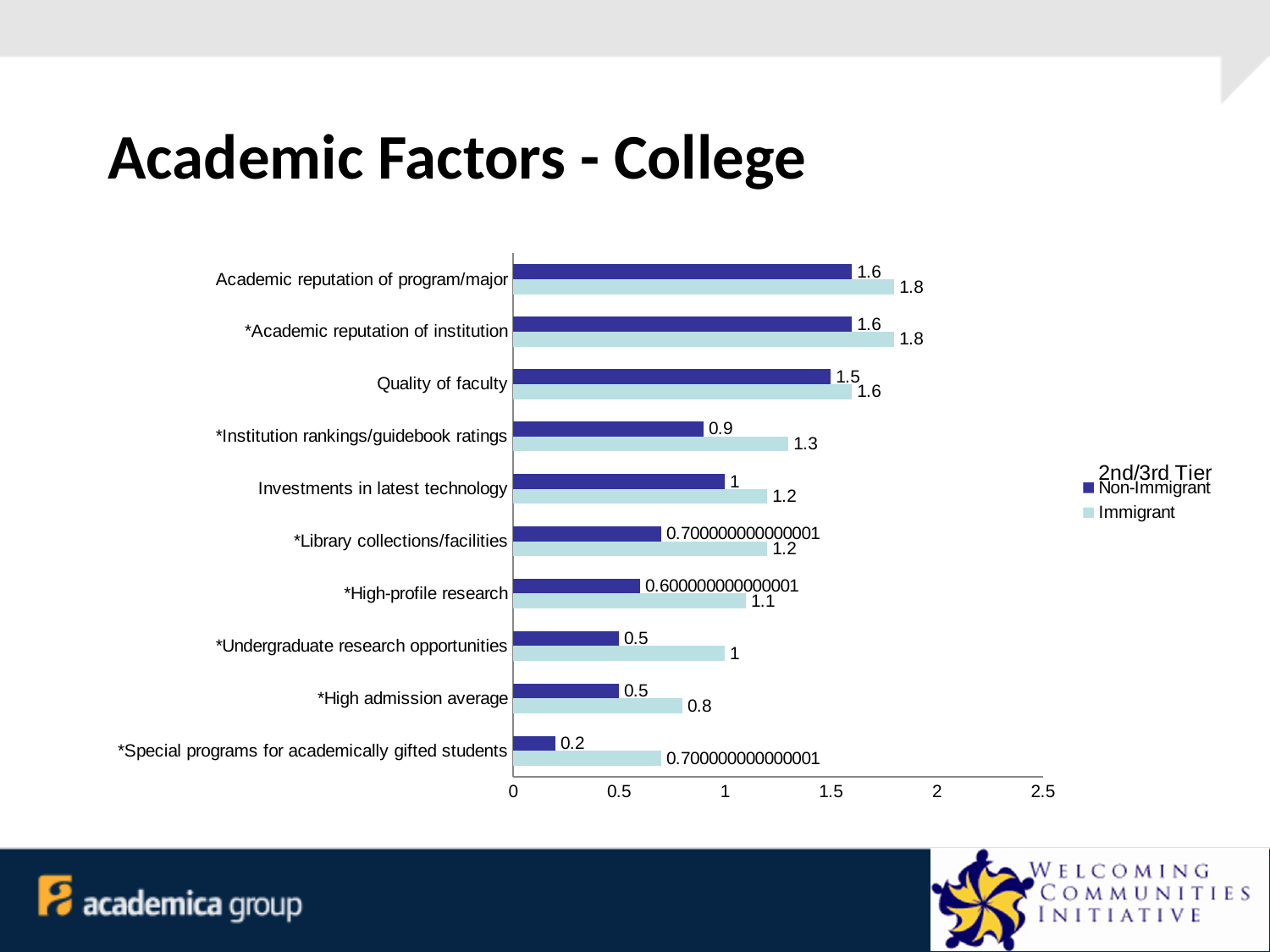
What is the Immigrant value for Quality of faculty? 1.6 What is the difference between the Immigrant and Non-Immigrant values for *Undergraduate research opportunities? 0.5 How many categories are shown on the chart? 10 What is the Immigrant value for *High admission average? 0.8 What kind of chart is shown on the slide? Bar chart How many series does the legend list? 2 What is the Non-Immigrant value for *Library collections/facilities, as printed on the slide? 0.700000000000001 Which is larger for Investments in latest technology, the Immigrant value or the Non-Immigrant value? Immigrant Which category has the lowest Non-Immigrant value? *Special programs for academically gifted students What is the difference between the Immigrant and Non-Immigrant values for *Institution rankings/guidebook ratings? 0.4 Which category has the lowest Immigrant value? *Special programs for academically gifted students What is the Non-Immigrant value for *Institution rankings/guidebook ratings? 0.9